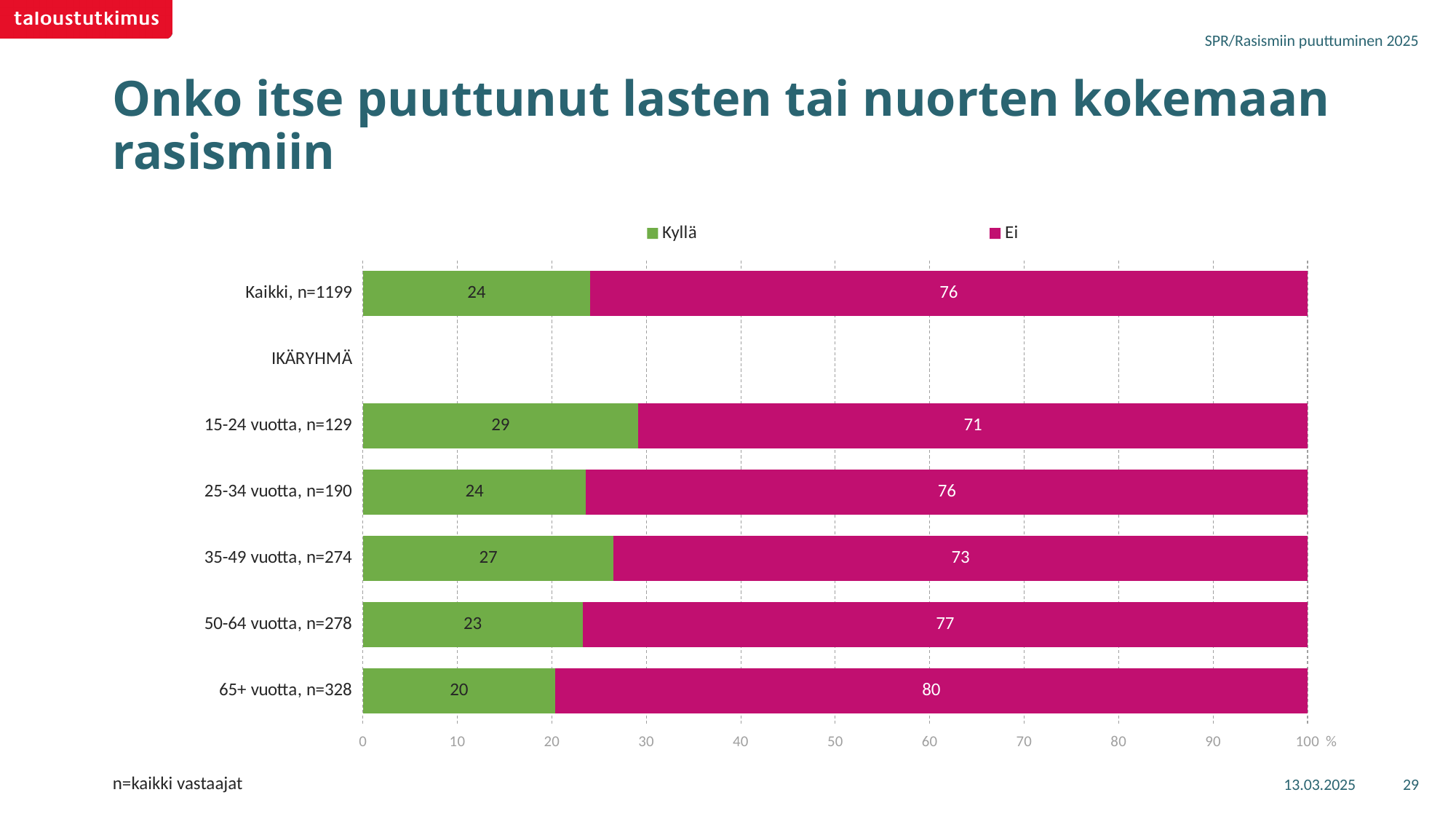
What kind of chart is shown on the slide? Stacked bar chart Which age group has the highest Kyllä value? 15-24 vuotta, n=129 Which series is shown in green? Kyllä How many series does the legend list? 2 What is the Kyllä value for Kaikki, n=1199? 24 Which age group has the lowest Kyllä value? 65+ vuotta, n=328 What is the total of the stacked bar for 50-64 vuotta, n=278? 100 Does the Kyllä value fall or rise from 15-24 vuotta to 65+ vuotta across the age groups? Falls overall What is the difference between the Ei values for 65+ vuotta, n=328 and 15-24 vuotta, n=129? 9 Which is larger, the Kyllä value for 25-34 vuotta, n=190 or for 50-64 vuotta, n=278? 25-34 vuotta, n=190 What is the Ei value for 65+ vuotta, n=328? 80 What is the Kyllä value for 35-49 vuotta, n=274? 27